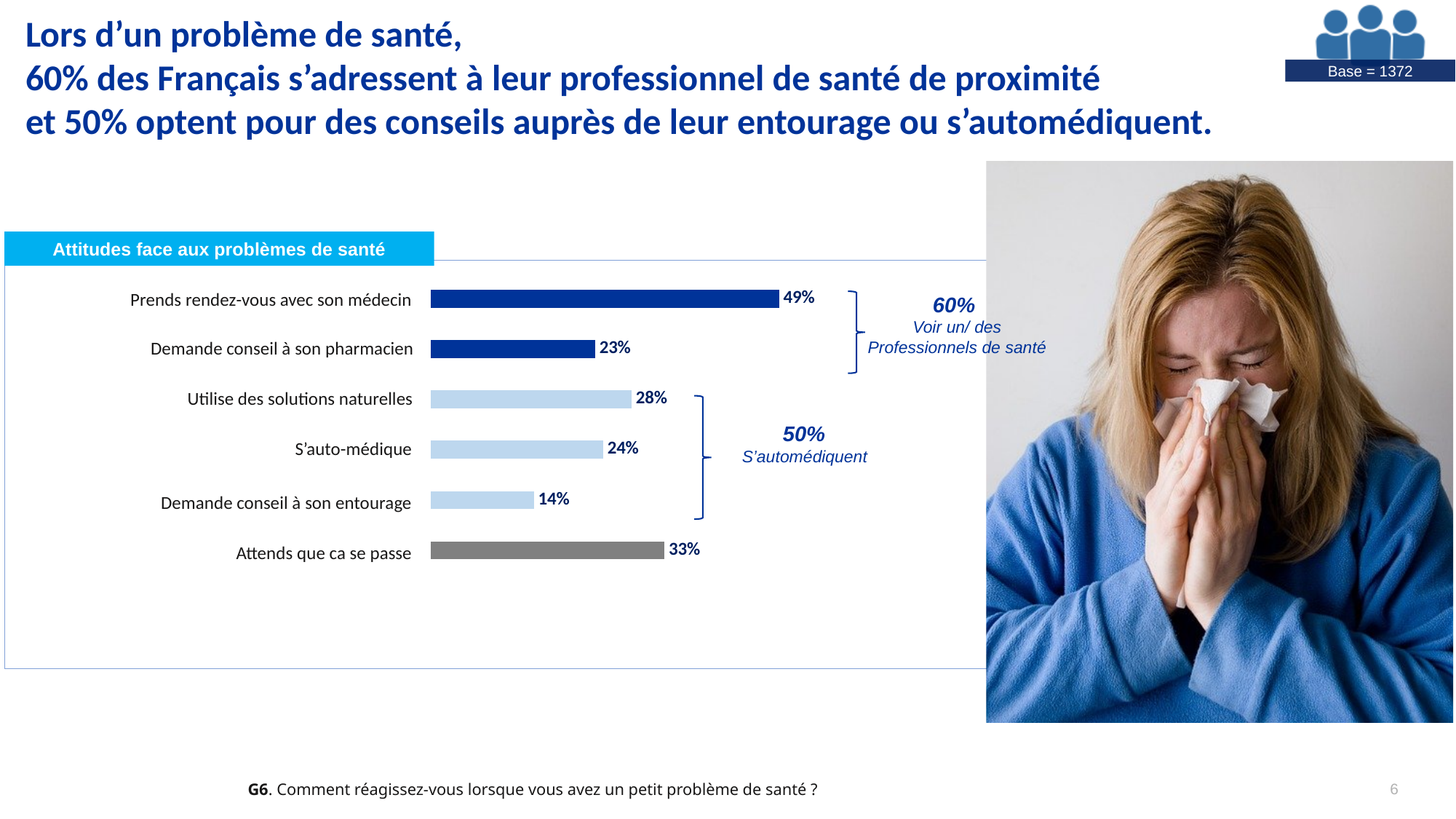
Which is larger: "S'auto-médique" or "Demande conseil à son entourage"? S'auto-médique What is the value for "Demande conseil à son pharmacien"? 23% What kind of chart is shown on the slide? Bar chart What is the title of the chart? Attitudes face aux problèmes de santé What is the value for "Attends que ca se passe"? 33% What is the value for "Utilise des solutions naturelles"? 28% What is the difference between "Prends rendez-vous avec son médecin" and "Demande conseil à son pharmacien"? 26% What percentage is shown next to the bracket labelled "S'automédiquent"? 50% How many categories are shown in the chart? 6 What is the value for "Prends rendez-vous avec son médecin"? 49% Which category has the lowest value? Demande conseil à son entourage Which category has the highest value? Prends rendez-vous avec son médecin